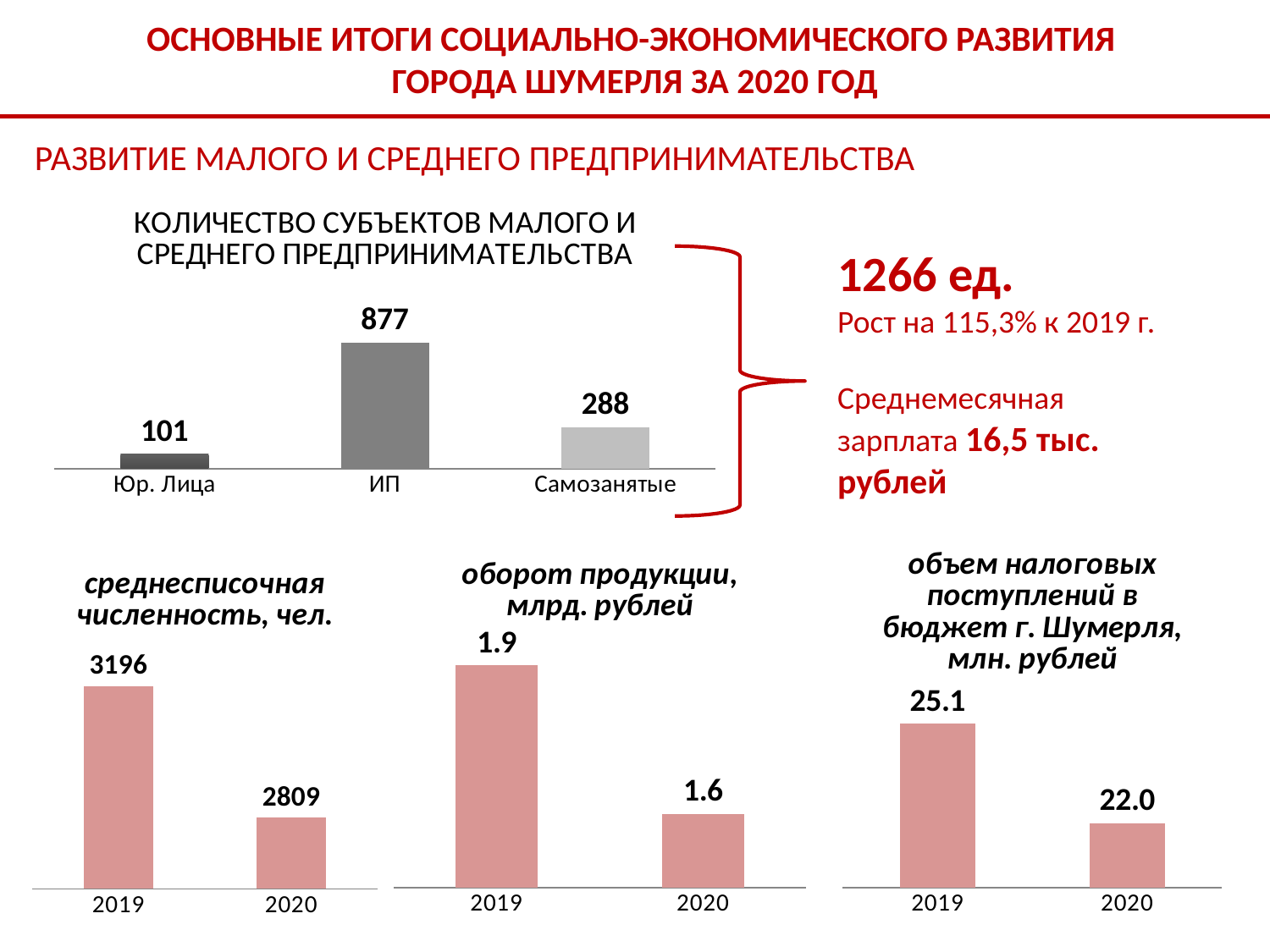
In the chart 'объем налоговых поступлений в бюджет г. Шумерля, млн. рублей', what is the difference between the 2019 and 2020 values? 3.1 In the chart 'КОЛИЧЕСТВО СУБЪЕКТОВ МАЛОГО И СРЕДНЕГО ПРЕДПРИНИМАТЕЛЬСТВА', which category has the lowest value? Юр. Лица In the chart 'среднесписочная численность, чел.', what is the value for 2020? 2809 In the chart 'объем налоговых поступлений в бюджет г. Шумерля, млн. рублей', what is the value for 2020? 22.0 What kind of chart is 'КОЛИЧЕСТВО СУБЪЕКТОВ МАЛОГО И СРЕДНЕГО ПРЕДПРИНИМАТЕЛЬСТВА'? Bar chart In the chart 'объем налоговых поступлений в бюджет г. Шумерля, млн. рублей', which year has the higher value, 2019 or 2020? 2019 In the chart 'оборот продукции, млрд. рублей', what is the value for 2019? 1.9 In the chart 'оборот продукции, млрд. рублей', do the values rise or fall from 2019 to 2020? Fall In the chart 'КОЛИЧЕСТВО СУБЪЕКТОВ МАЛОГО И СРЕДНЕГО ПРЕДПРИНИМАТЕЛЬСТВА', what is the value for ИП? 877 In the chart 'КОЛИЧЕСТВО СУБЪЕКТОВ МАЛОГО И СРЕДНЕГО ПРЕДПРИНИМАТЕЛЬСТВА', how many categories are shown? 3 In the chart 'КОЛИЧЕСТВО СУБЪЕКТОВ МАЛОГО И СРЕДНЕГО ПРЕДПРИНИМАТЕЛЬСТВА', what is the difference between the values for ИП and Самозанятые? 589 In the chart 'среднесписочная численность, чел.', what is the difference between the 2019 and 2020 values? 387